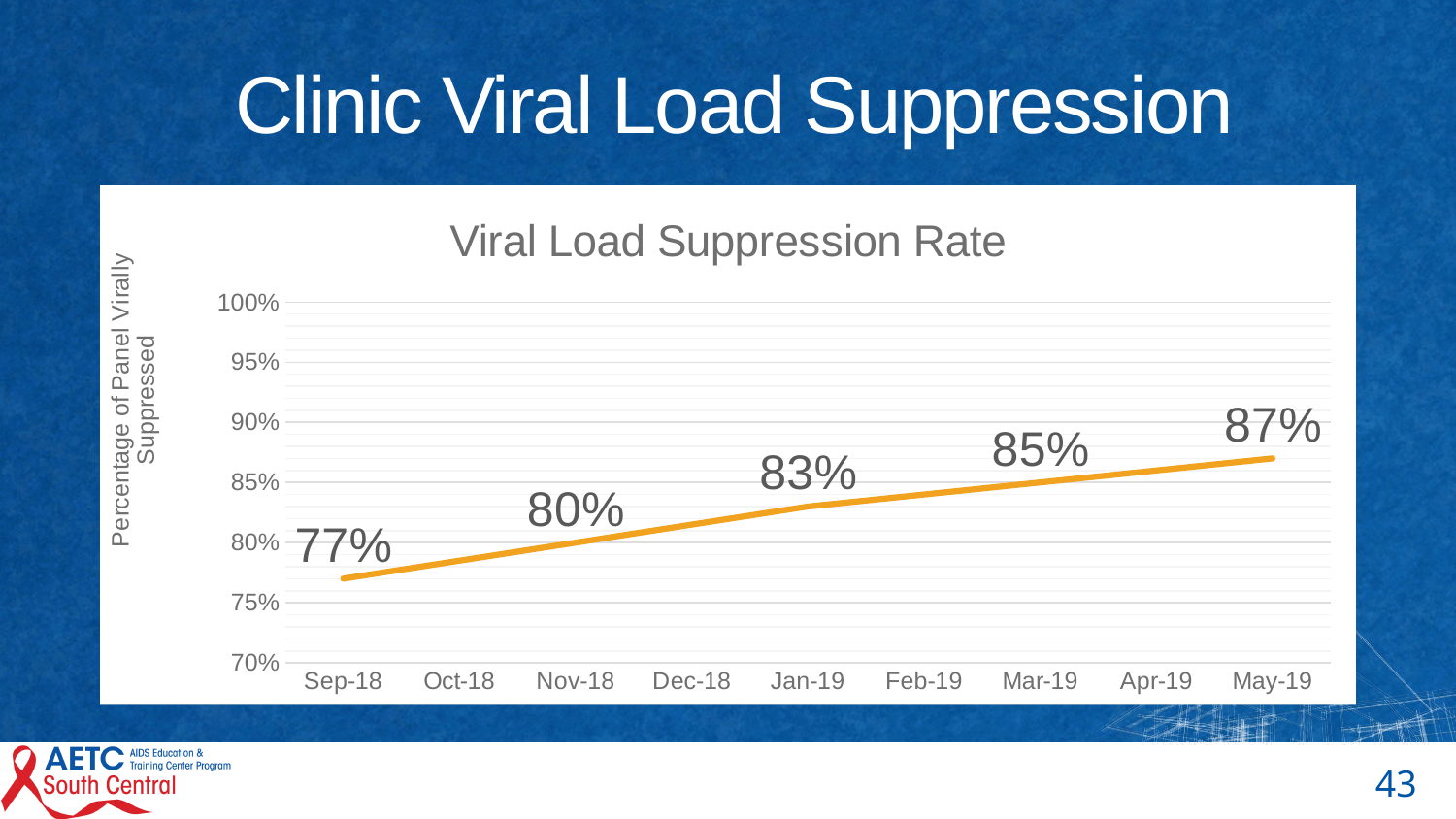
What is the title of the chart? Viral Load Suppression Rate What is the viral load suppression rate labelled at Sep-18? 77% How many month labels are shown on the x axis? 9 By how many percentage points did the viral load suppression rate increase from Sep-18 to May-19? 10 percentage points What is the viral load suppression rate labelled at Mar-19? 85% Which month has the highest labelled viral load suppression rate? May-19 What is the viral load suppression rate labelled at May-19? 87% What is the viral load suppression rate labelled at Jan-19? 83% What is the viral load suppression rate labelled at Nov-18? 80% What type of chart is shown on the slide? Line chart Does the viral load suppression rate rise or fall from Sep-18 to May-19? Rise Which month has the lowest labelled viral load suppression rate? Sep-18